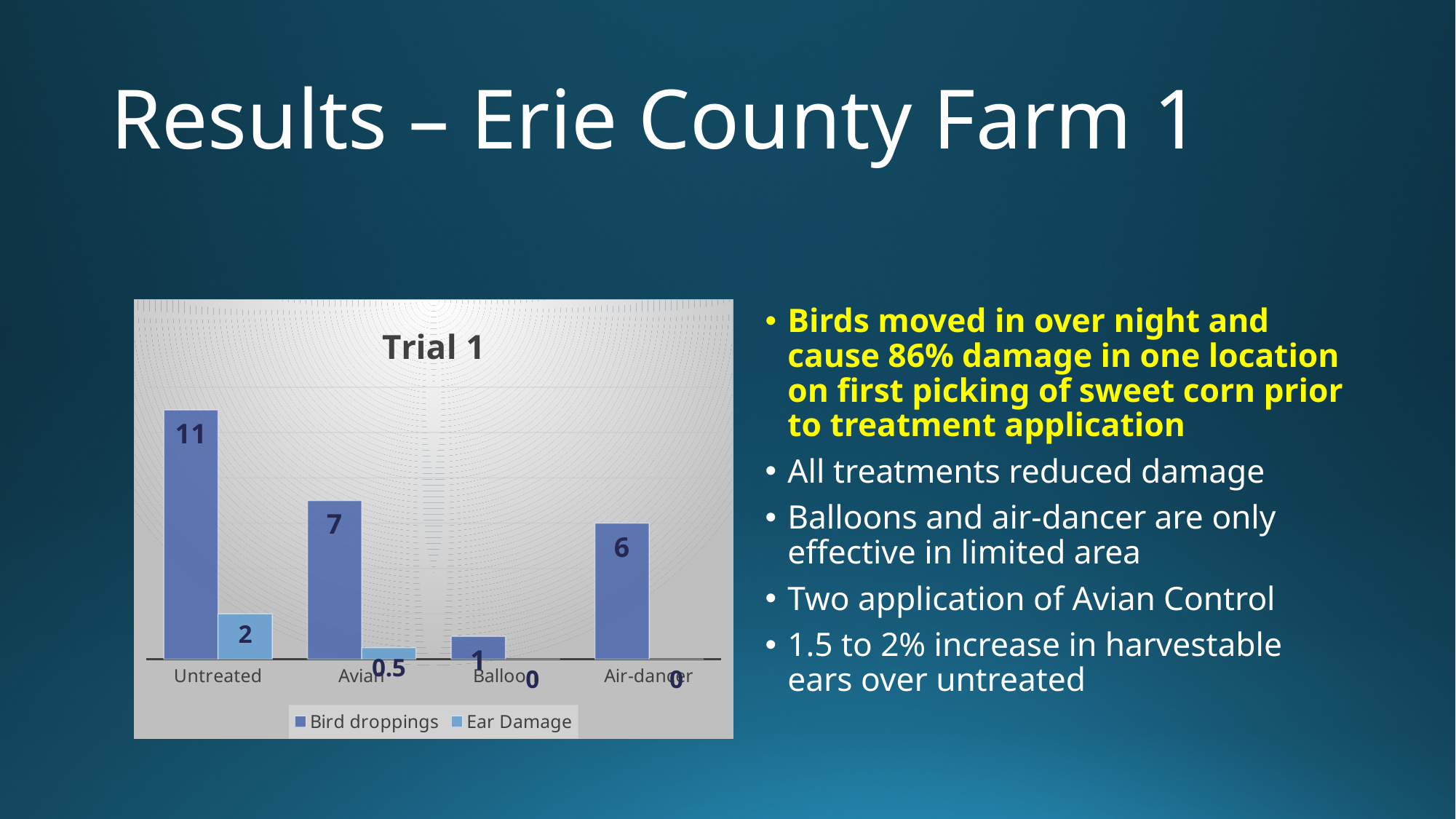
Which category has the lowest Bird droppings value? Balloon What is the Ear Damage value for Avian? 0.5 What is the title of the chart? Trial 1 What is the difference between the Bird droppings values for Untreated and Avian? 4 Which category has the highest Bird droppings value? Untreated What is the Ear Damage value for Untreated? 2 What is the Bird droppings value for Air-dancer? 6 What is the Bird droppings value for Untreated? 11 What type of chart is shown on the slide? bar chart Which has a larger Bird droppings value, Avian or Air-dancer? Avian How many categories are shown on the x axis of the chart? 4 How many series does the chart legend list? 2